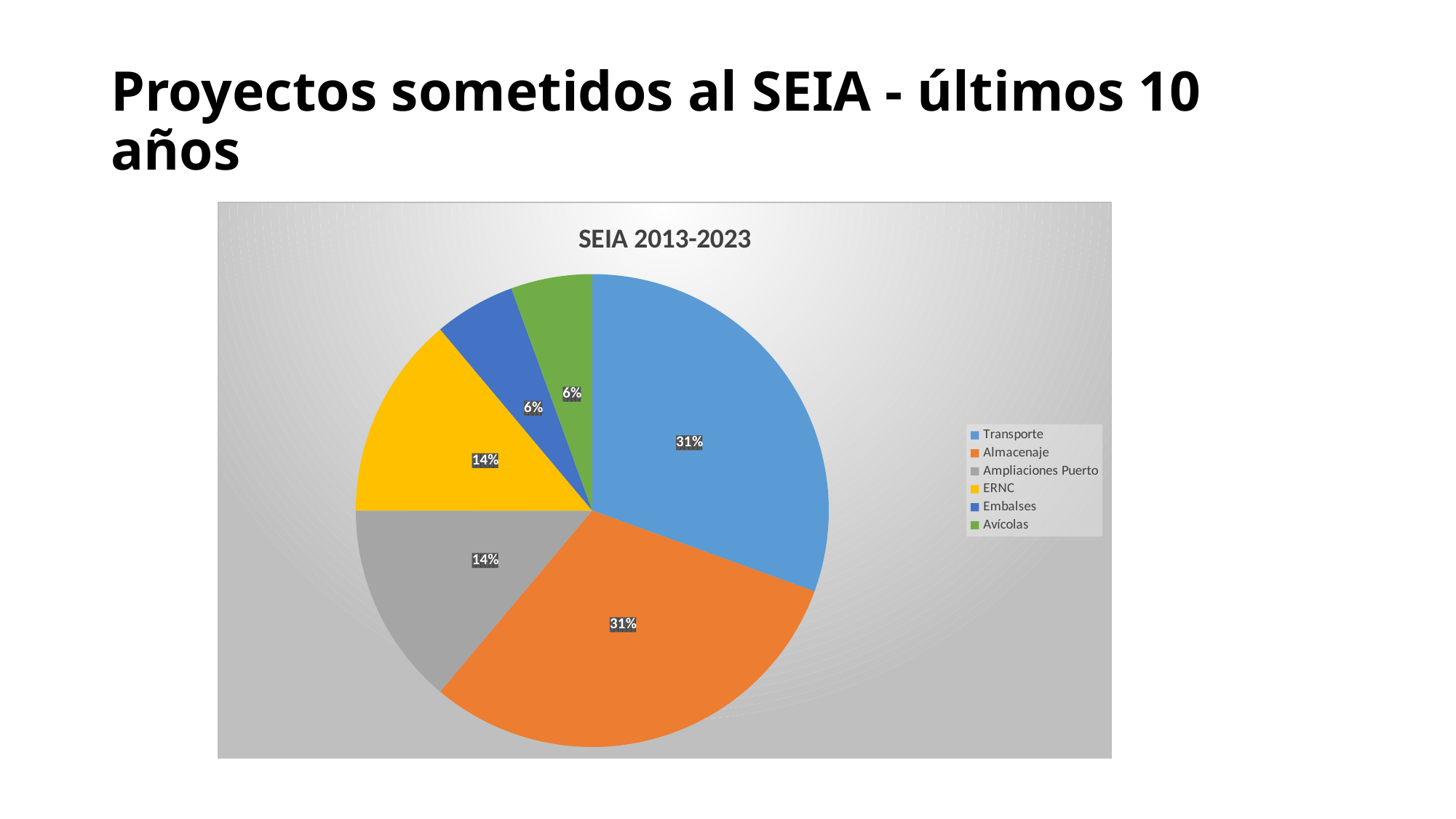
What is the difference in percentage points between Almacenaje and Embalses? 25 What percentage of the pie does Transporte represent? 31% What percentage of the pie does Almacenaje represent? 31% Which colour represents ERNC in the legend? yellow What is the value shown for Ampliaciones Puerto? 14% Which is larger, the share for Transporte or the share for ERNC? Transporte What kind of chart is shown on the slide? pie chart What is the value shown for Avícolas? 6% How many categories does the pie chart have? 6 What is the value shown for Embalses? 6% What is the value shown for ERNC? 14% What is the title of the chart? SEIA 2013-2023